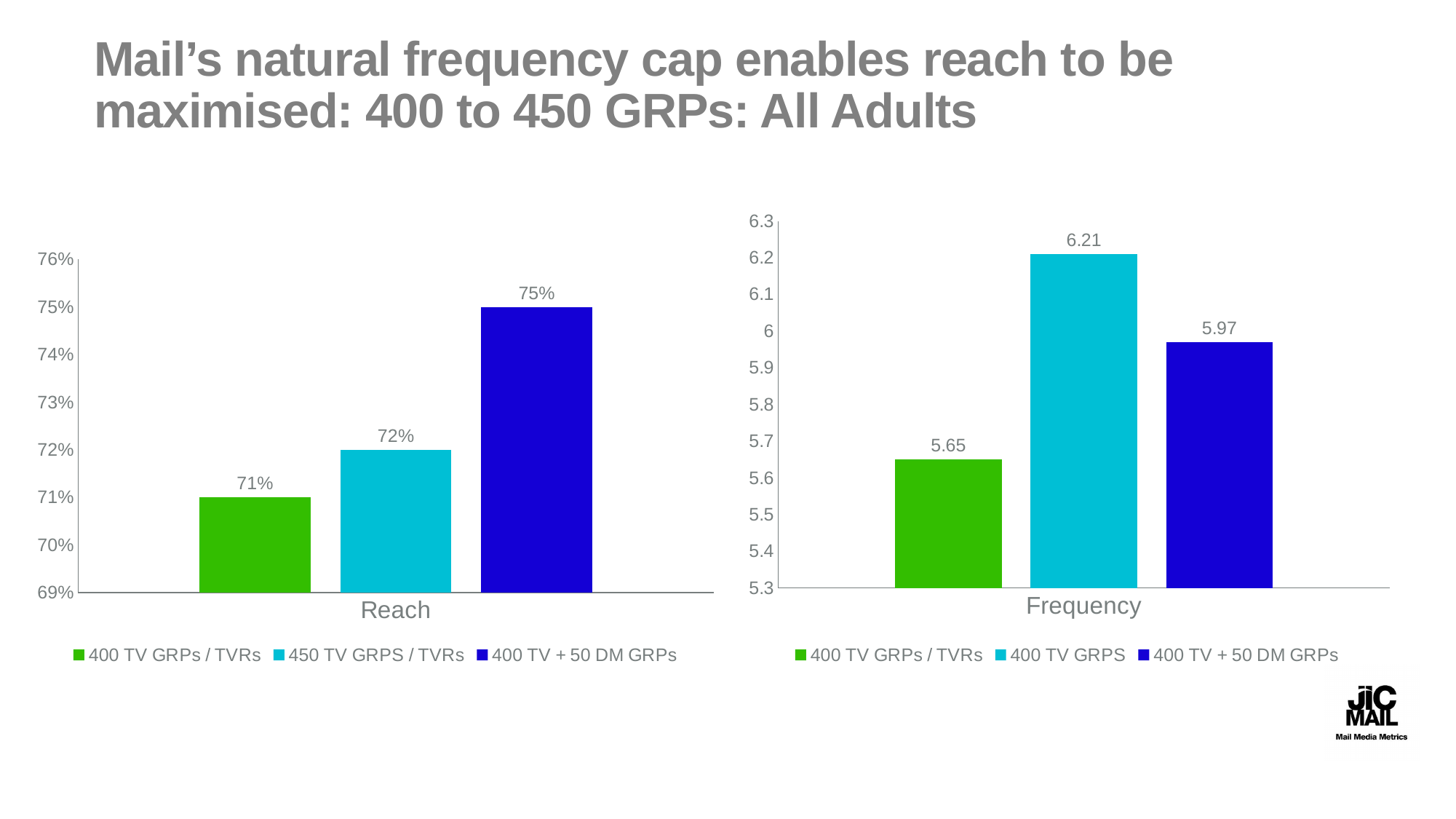
In the Frequency chart on the right, which series has the lowest value? 400 TV GRPs / TVRs In the Frequency chart on the right, what is the difference between the 400 TV GRPS value and the 400 TV GRPs / TVRs value? 0.56 In the Reach chart on the left, what is the value for 400 TV + 50 DM GRPs? 75% In the Frequency chart on the right, is the value for 400 TV GRPs / TVRs greater or less than 5.7? less In the Reach chart on the left, which series has the highest value? 400 TV + 50 DM GRPs In the Reach chart on the left, what is the difference between the 400 TV + 50 DM GRPs value and the 450 TV GRPS / TVRs value? 3% How many series does the legend of the Reach chart on the left list? 3 In the Reach chart on the left, what is the value for 400 TV GRPs / TVRs? 71% What kind of chart is the Frequency chart on the right? Bar chart In the Frequency chart on the right, what is the value for 400 TV + 50 DM GRPs? 5.97 In the Frequency chart on the right, which is larger: the value for 400 TV GRPS or the value for 400 TV + 50 DM GRPs? 400 TV GRPS In the Frequency chart on the right, what is the value for 400 TV GRPS? 6.21